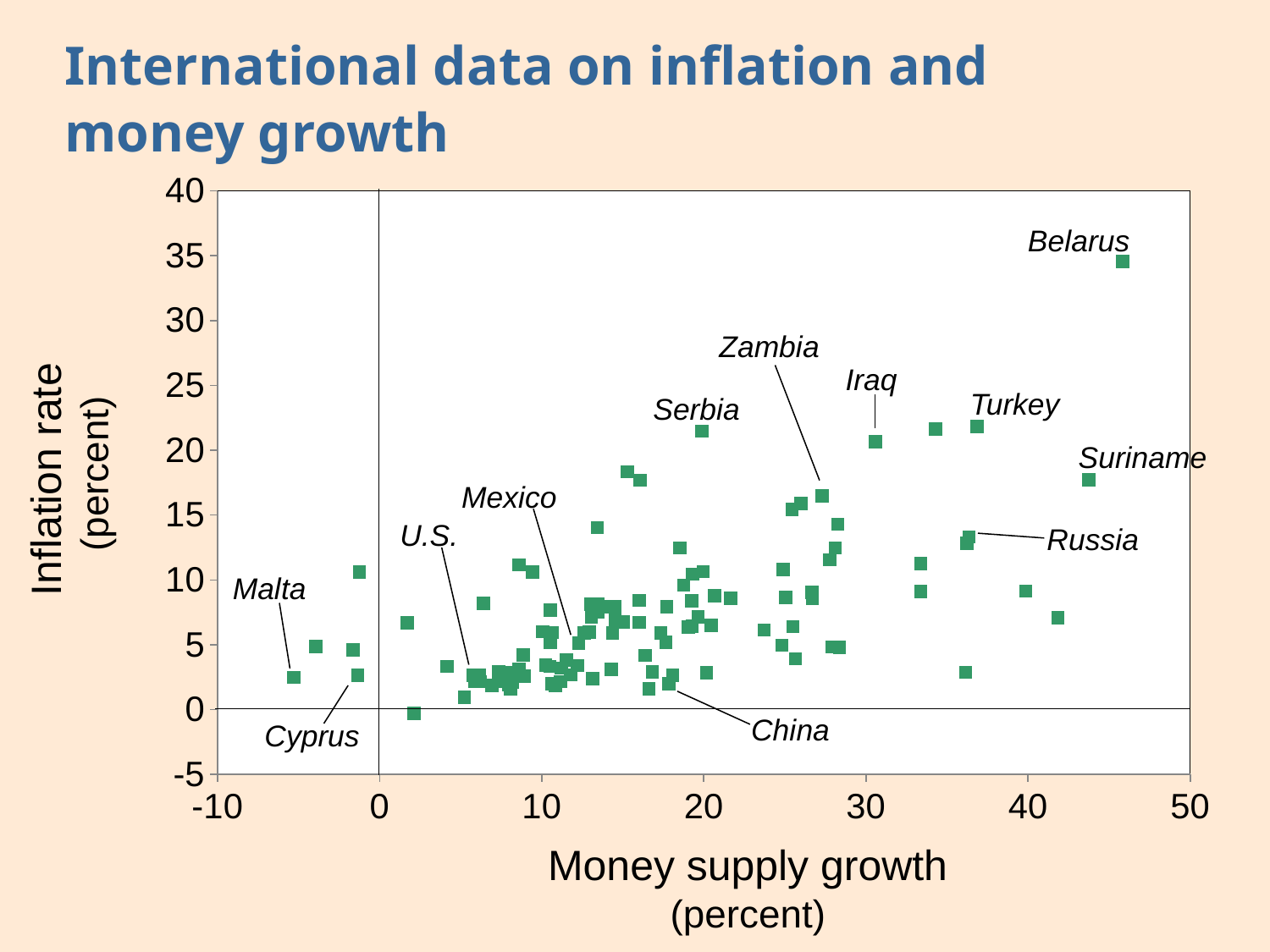
Is the inflation rate for Turkey greater or less than 20? greater Is the money supply growth for Suriname greater or less than 40? greater Is the money supply growth for Malta greater or less than 0? less Which labeled country has the lowest money supply growth? Malta What kind of chart is shown on the slide? scatter plot Which has the higher money supply growth, Malta or Belarus? Belarus What is the label of the horizontal axis? Money supply growth (percent) Which has the higher inflation rate, Belarus or Suriname? Belarus Which labeled country has the highest inflation rate? Belarus